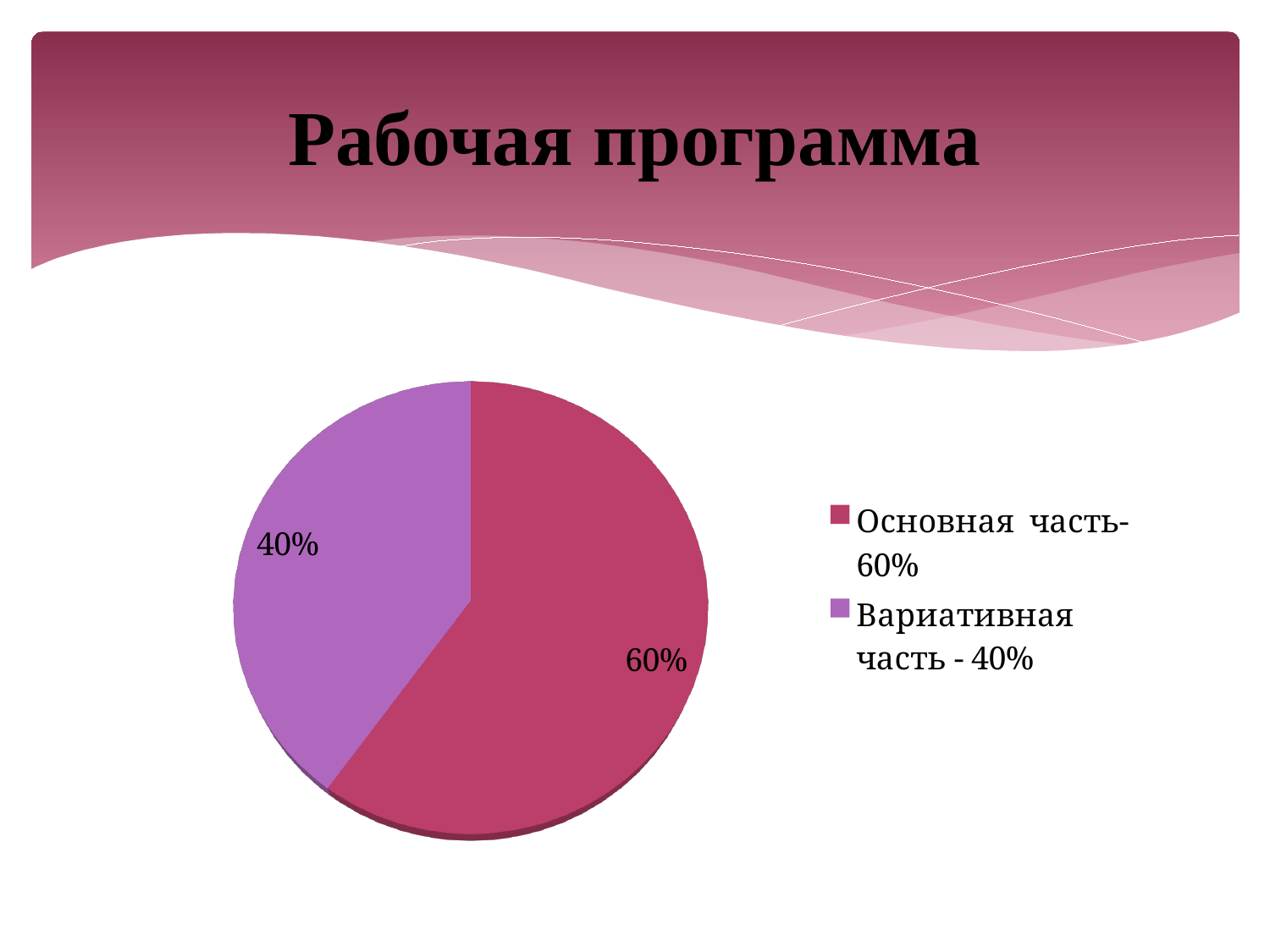
Which is larger, "Основная часть" or "Вариативная часть"? Основная часть What is the total of the two slices shown in the pie chart? 100% What is the difference in percentage points between "Основная часть" and "Вариативная часть"? 20% What share of the pie does "Основная часть" take? 60% How many entries does the legend list? 2 What kind of chart is shown on the slide? pie chart How many slices does the pie chart have? 2 Which slice of the pie is the largest? Основная часть What is the title shown above the chart on the slide? Рабочая программа What colour is the slice for "Вариативная часть"? purple Which slice of the pie is the smallest? Вариативная часть What share of the pie does "Вариативная часть" take? 40%